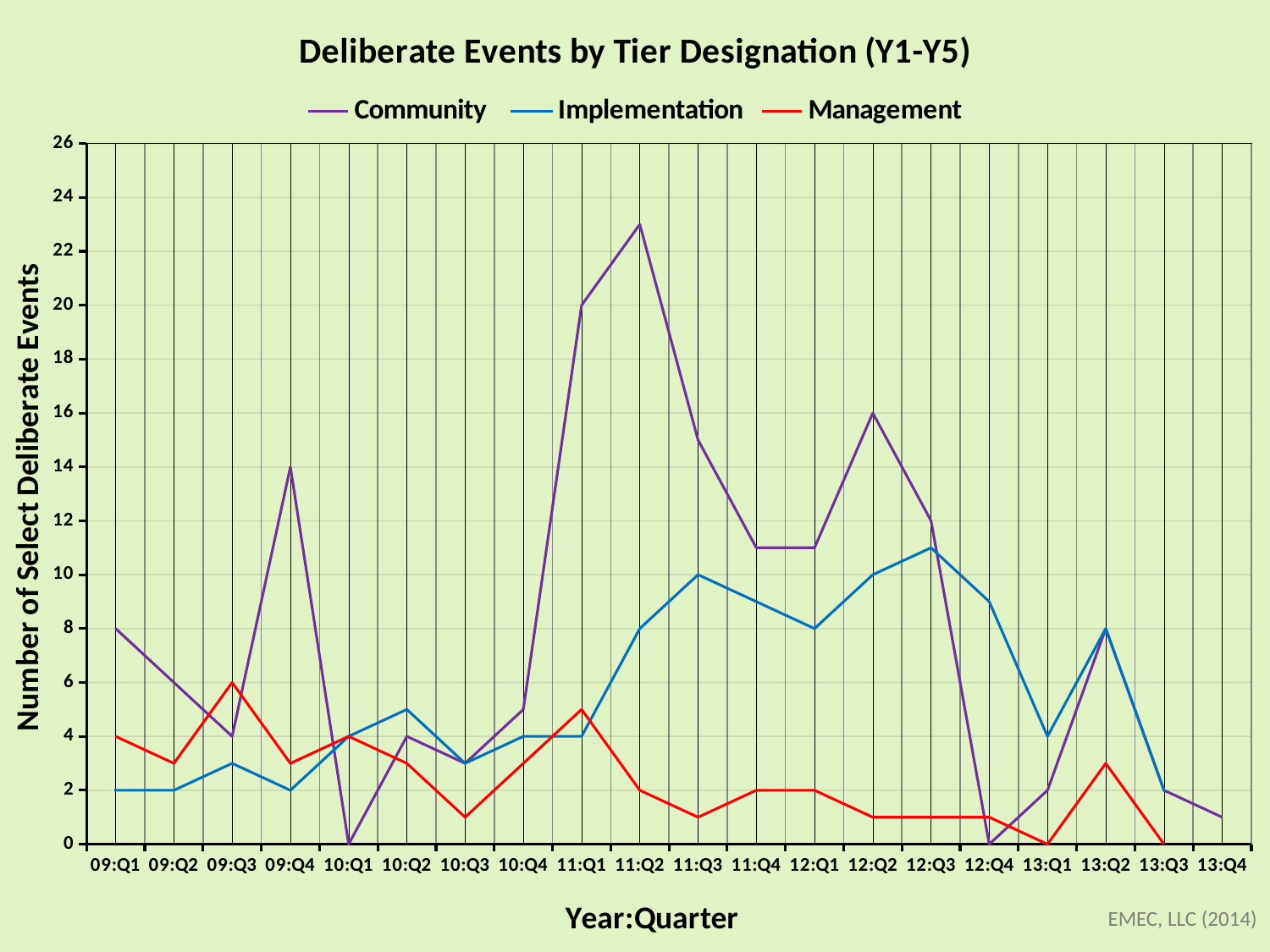
Does the Community series rise or fall from 11:Q2 to 11:Q4? fall How many series does the legend list? 3 What is the difference between the Community and Implementation values in 11:Q1? 16 In which quarter does the Community series reach its highest value? 11:Q2 How many quarters are shown along the x axis? 20 In which quarter does the Management series reach its highest value? 09:Q3 Is the value for Community in 11:Q2 greater or less than 20? greater What is the value for Management in 09:Q3? 6 What is the value for Community in 11:Q1? 20 What is the value for Implementation in 11:Q3? 10 What kind of chart is shown on the slide? line chart In 09:Q3, which is larger, the Management value or the Community value? Management